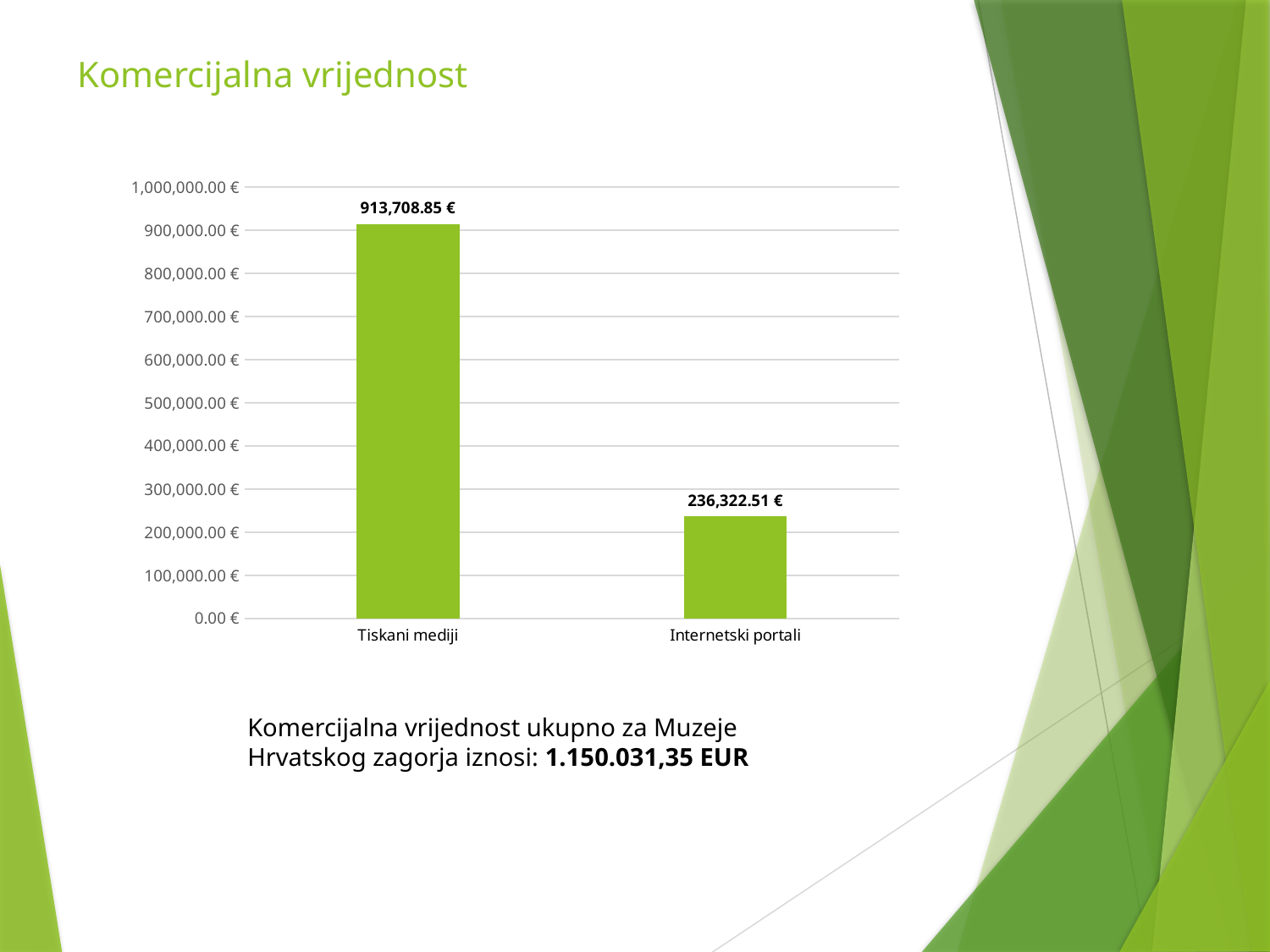
What is the title of the slide containing the chart? Komercijalna vrijednost Is the value for Internetski portali greater or less than 300,000.00 €? less Which category has the lowest value? Internetski portali What is the value for Tiskani mediji? 913,708.85 € How many categories are shown on the x axis of the chart? 2 Is the value for Tiskani mediji greater or less than 900,000.00 €? greater What kind of chart is shown on the slide? bar chart What is the value for Internetski portali? 236,322.51 € What is the highest value shown on the y axis of the chart? 1,000,000.00 € Which is larger, the value for Tiskani mediji or the value for Internetski portali? Tiskani mediji What is the difference between the values for Tiskani mediji and Internetski portali? 677,386.34 € Which category has the highest value? Tiskani mediji